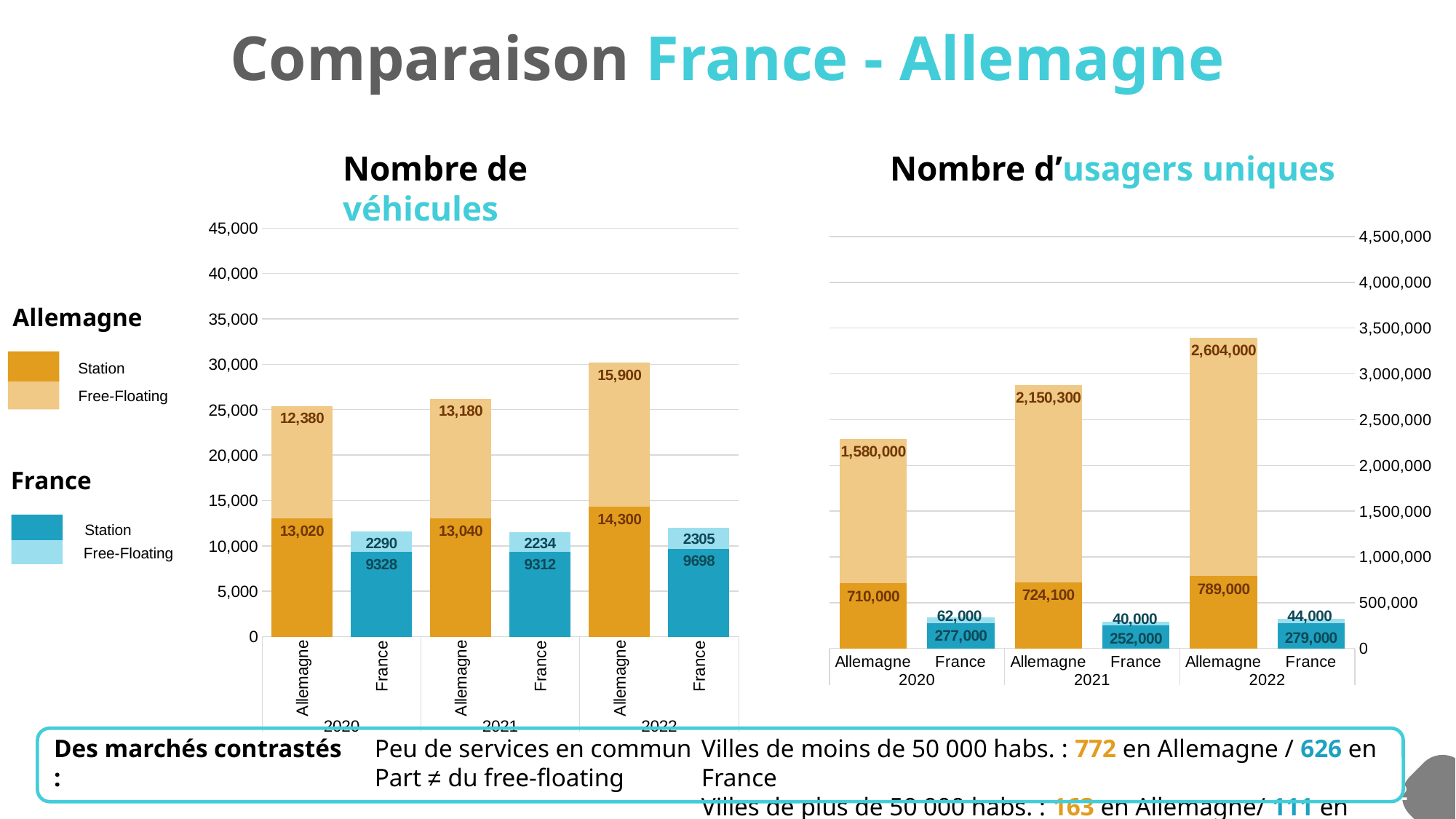
In the 'Nombre d'usagers uniques' chart, is the total bar for Allemagne in 2022 greater or less than 3,000,000? greater In the 'Nombre de véhicules' chart, what is the difference between the Allemagne Free-Floating values in 2022 and 2021? 2,720 In the 'Nombre de véhicules' chart, do the Allemagne Free-Floating values rise or fall from 2020 to 2022? rise In the 'Nombre d'usagers uniques' chart, which year has the highest Allemagne Free-Floating value? 2022 In the 'Nombre d'usagers uniques' chart, what is the Free-Floating value for Allemagne in 2021? 2,150,300 What kind of chart is the 'Nombre d'usagers uniques' chart? stacked bar chart In the 'Nombre d'usagers uniques' chart, what is the total of the stacked bar for France in 2022? 323,000 In the 'Nombre de véhicules' chart, what is the Free-Floating value for France in 2021? 2234 In the 'Nombre de véhicules' chart, which is larger: the France Station value in 2022 or in 2020? 2022 In the 'Nombre de véhicules' chart, what is the total height of the stacked bar for Allemagne in 2020? 25,400 In the 'Nombre de véhicules' chart, what is the Station value for Allemagne in 2022? 14,300 In the 'Nombre d'usagers uniques' chart, what is the Station value for France in 2020? 277,000